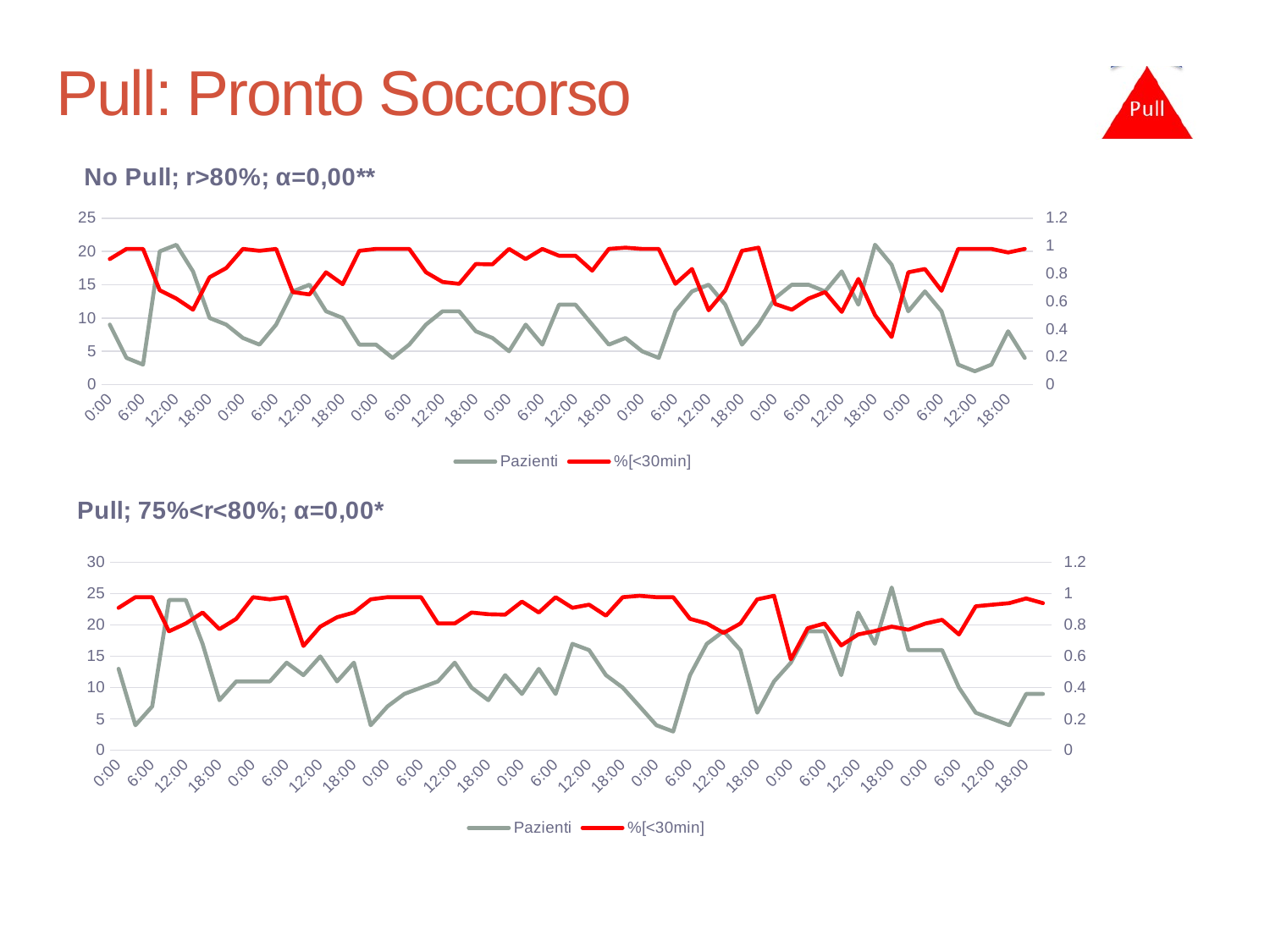
What kind of chart is the bottom chart on the slide? Line chart In the top chart, is the lowest value of the %[<30min] series greater or less than 0.4? less Which two series are listed in the legend of the bottom chart? Pazienti and %[<30min] How many series does the legend of the bottom chart list? 2 In the top chart, is the highest value of the Pazienti series greater or less than 15? greater In the bottom chart, is the lowest value of the Pazienti series greater or less than 5? less What kind of chart is the top chart on the slide? Line chart What is the title of the top chart? No Pull; r>80%; α=0,00** How many series does the legend of the top chart list? 2